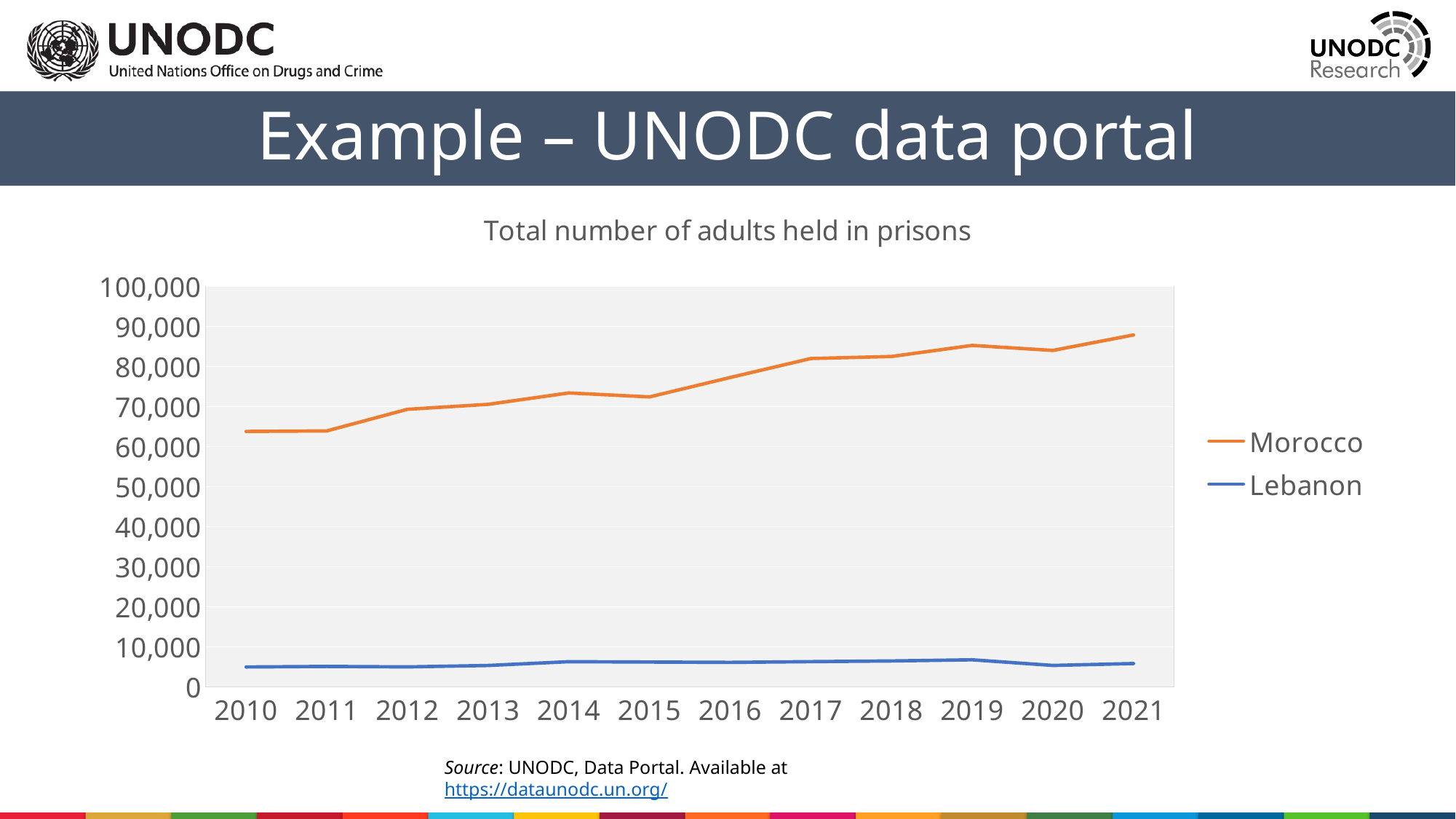
In which year does the Morocco series reach its highest value? 2021 What is the title of the chart? Total number of adults held in prisons Does the Morocco series generally rise or fall from 2010 to 2021? rise Is the value for Morocco in 2015 greater or less than 80,000? less Is the value for Morocco in 2021 greater or less than 90,000? less Is the value for Morocco in 2010 greater or less than 60,000? greater What kind of chart is shown on the slide? line chart Which countries are listed in the legend? Morocco and Lebanon Which series has the higher values throughout the chart, Morocco or Lebanon? Morocco How many years are shown on the x axis? 12 How many series does the legend list? 2